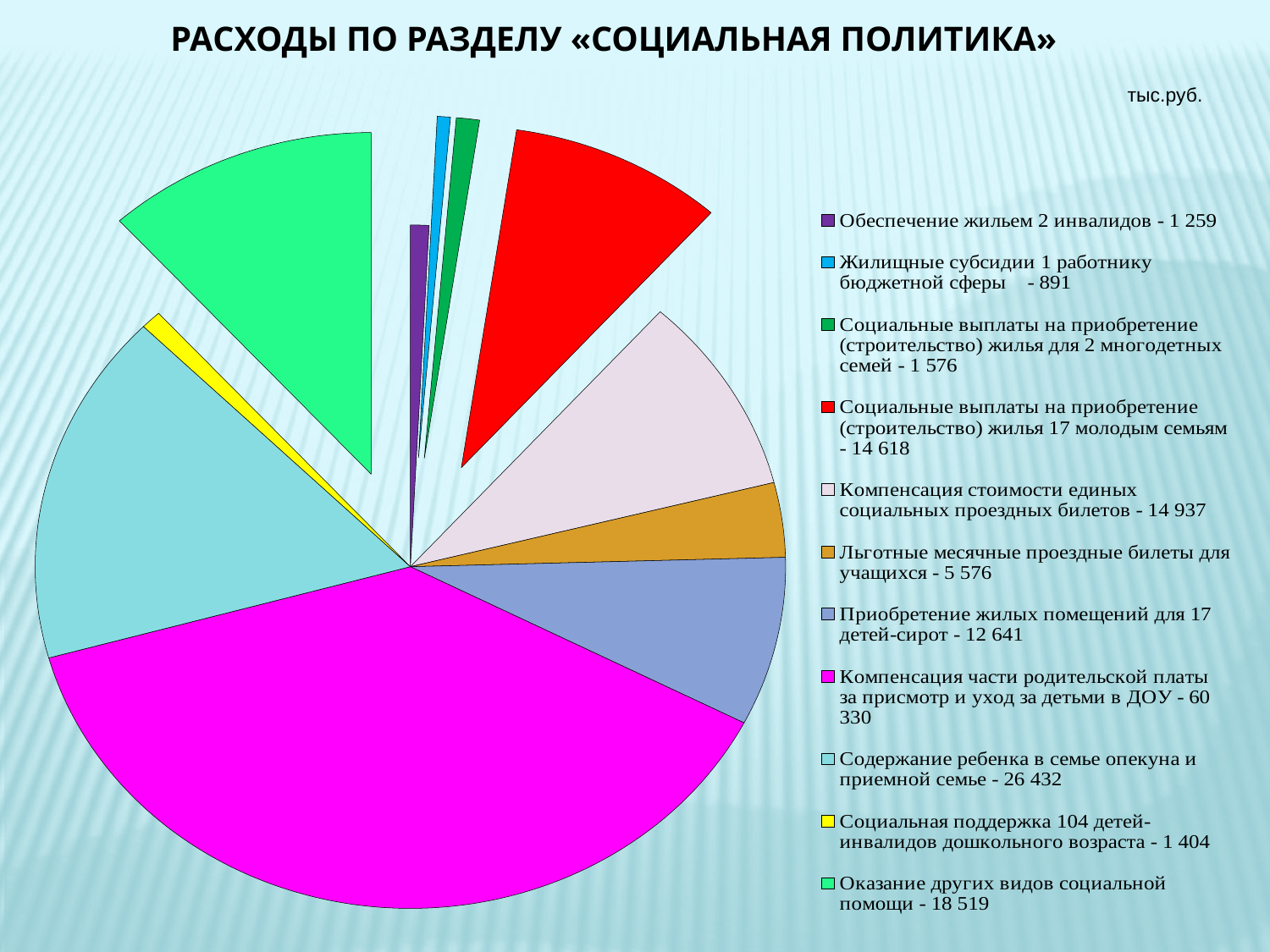
How many categories does the pie chart have? 11 Which category has the smallest value in the pie chart? Жилищные субсидии 1 работнику бюджетной сферы What kind of chart is shown on the slide? Pie chart What is the value for «Содержание ребенка в семье опекуна и приемной семье»? 26 432 In what units are the values on the slide given? тыс.руб. Which category has the largest value in the pie chart? Компенсация части родительской платы за присмотр и уход за детьми в ДОУ What is the value for «Оказание других видов социальной помощи»? 18 519 What is the value for «Льготные месячные проездные билеты для учащихся»? 5 576 What is the difference between «Содержание ребенка в семье опекуна и приемной семье» and «Оказание других видов социальной помощи»? 7 913 Which is larger: «Приобретение жилых помещений для 17 детей-сирот» or «Компенсация стоимости единых социальных проездных билетов»? Компенсация стоимости единых социальных проездных билетов What is the value for «Компенсация части родительской платы за присмотр и уход за детьми в ДОУ»? 60 330 What is the difference between «Компенсация стоимости единых социальных проездных билетов» and «Социальные выплаты на приобретение (строительство) жилья 17 молодым семьям»? 319